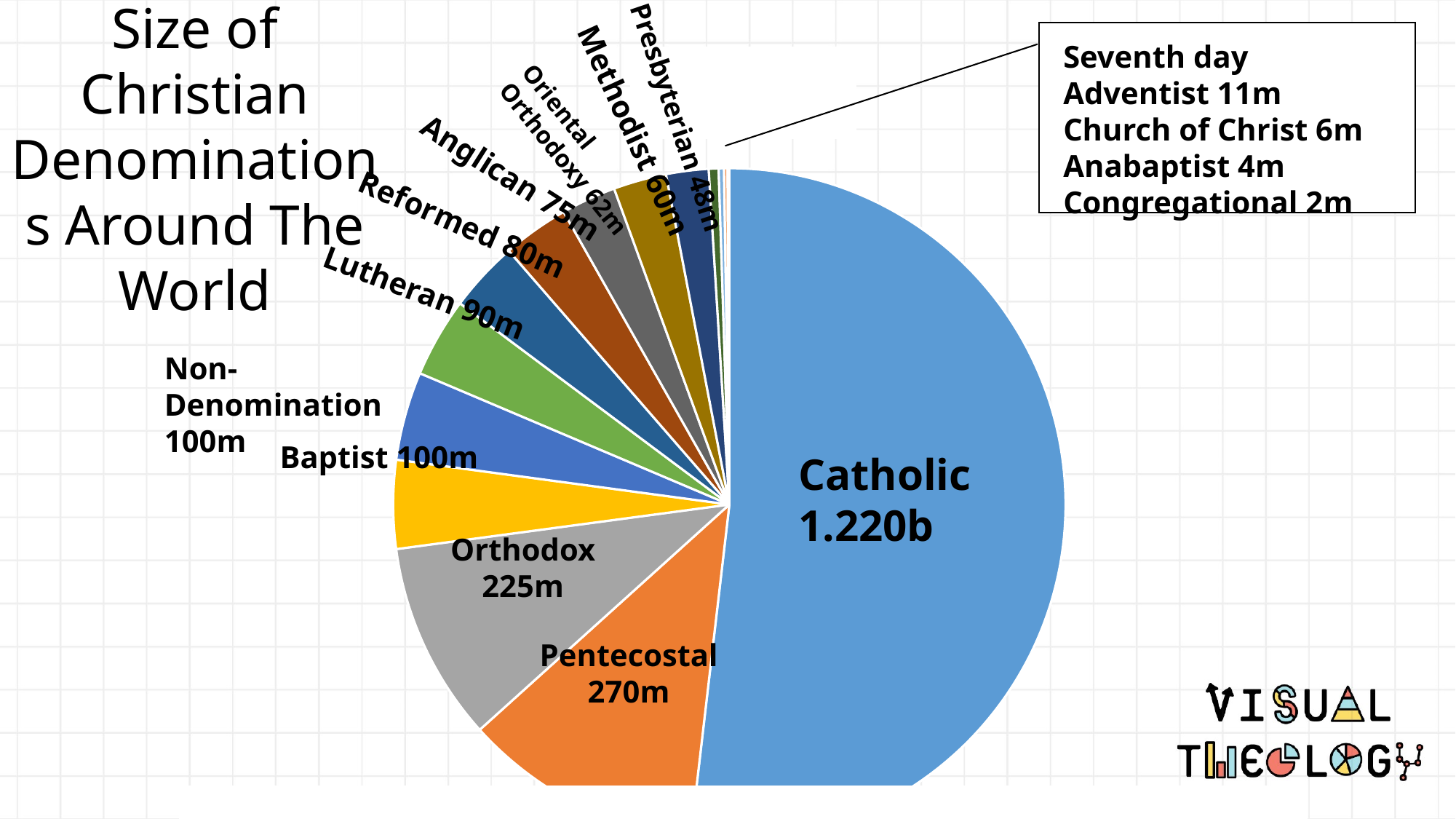
Which denomination has the smallest value shown? Congregational Which is larger, the value for Lutheran or the value for Reformed? Lutheran What is the title of the chart? Size of Christian Denominations Around The World What kind of chart is shown on the slide? pie chart What is the value shown for Orthodox? 225m What is the difference between the Pentecostal and Orthodox values? 45m What is the value shown for Pentecostal? 270m What is the value shown for Seventh day Adventist? 11m How many denominations are shown in the chart? 15 Which denomination has the largest slice of the pie? Catholic What is the value shown for Presbyterian? 48m What is the value shown for Catholic? 1.220b